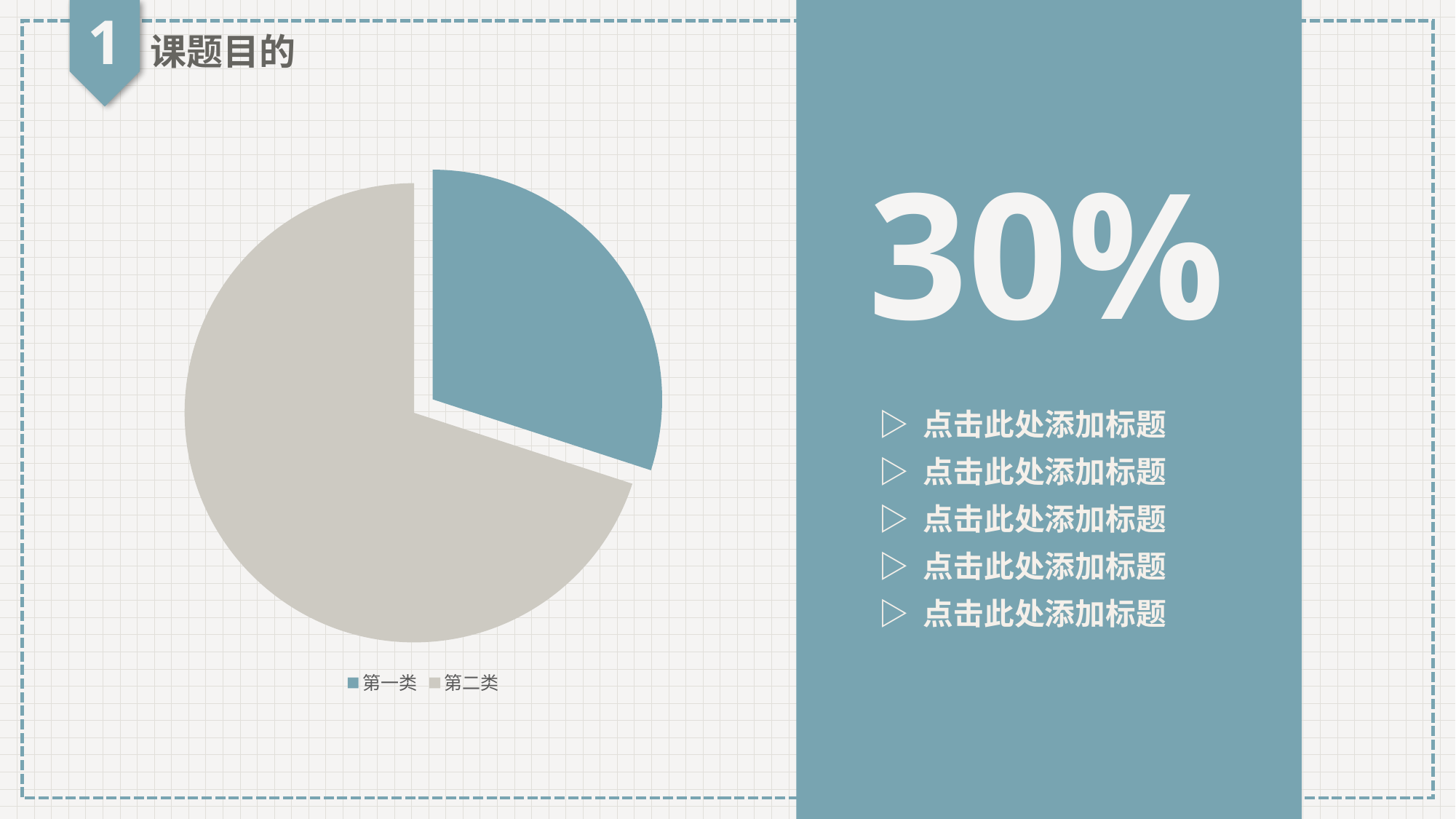
How many entries does the pie chart's legend list? 2 Which category has the largest slice in the pie chart? 第二类 What kind of chart is shown on the slide? pie chart Which slice is larger in the pie chart, 第一类 or 第二类? 第二类 What colour is the 第一类 slice in the pie chart? blue Which category has the smallest slice in the pie chart? 第一类 How many slices does the pie chart have? 2 What are the two legend entries of the pie chart? 第一类, 第二类